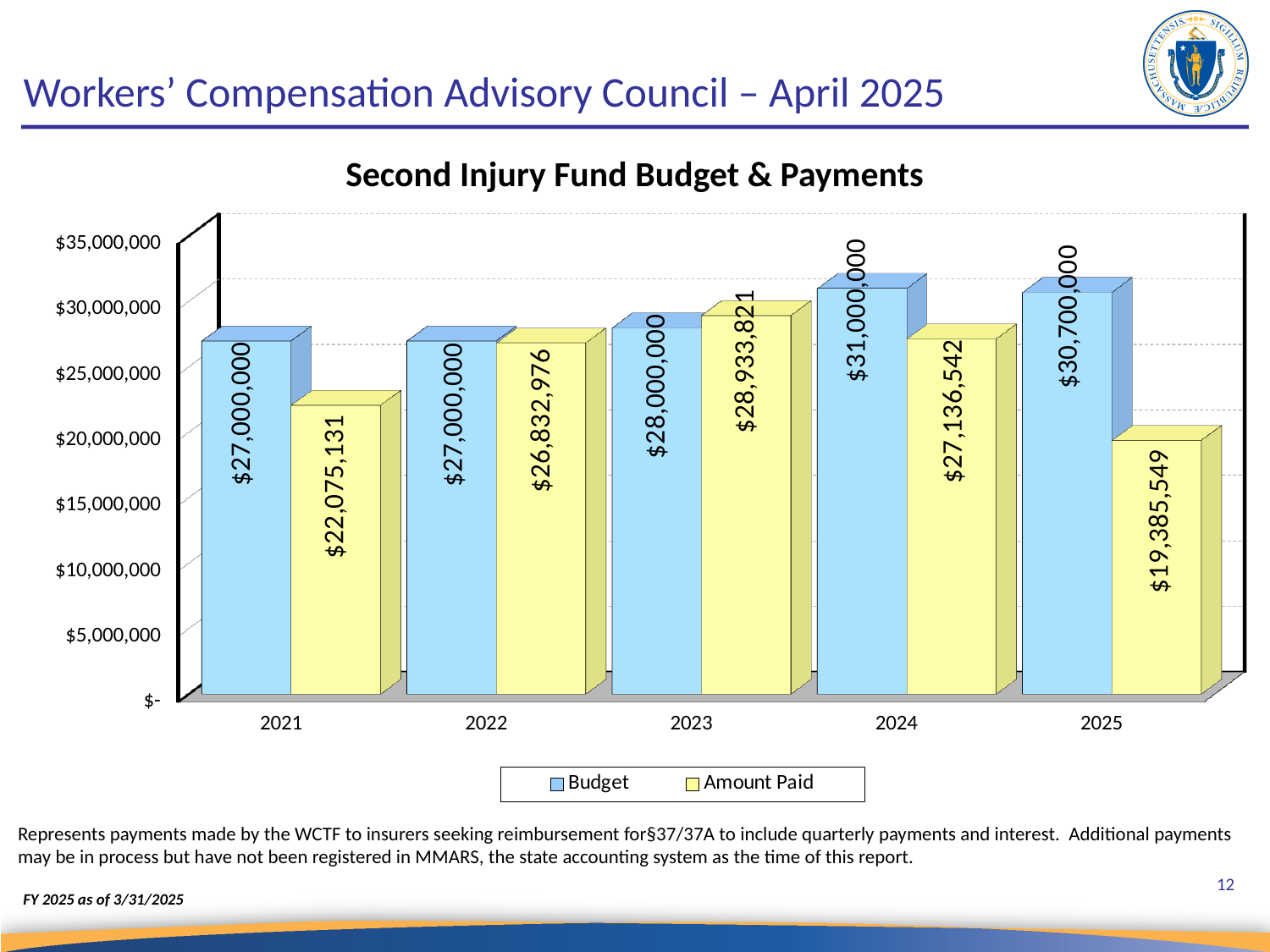
What is the Amount Paid for 2022? $26,832,976 What type of chart is shown on the slide? Bar chart Which year has the highest Budget? 2024 Which year has the lowest Amount Paid? 2025 What is the difference between the Budget and the Amount Paid in 2021? $4,924,869 In 2023, which is larger, the Budget or the Amount Paid? Amount Paid What is the difference between the Budget and the Amount Paid in 2025? $11,314,451 What is the Budget value for 2024? $31,000,000 How many series does the legend list? 2 How many years are shown on the x axis? 5 Which year has the highest Amount Paid? 2023 What is the Amount Paid for 2025? $19,385,549